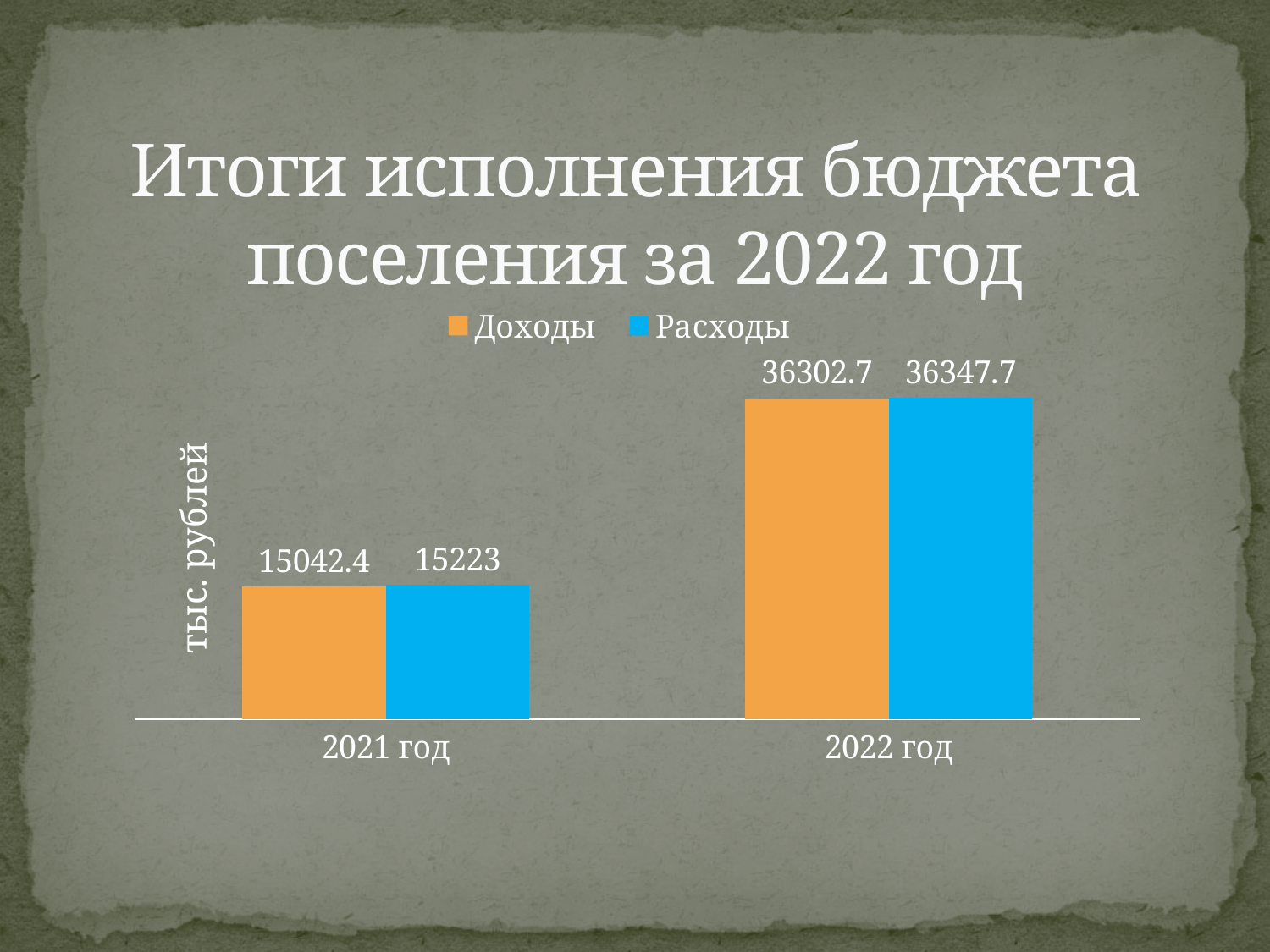
What is the value of Доходы for 2022 год? 36302.7 What is the value of Расходы for 2022 год? 36347.7 Which year has the lower value for Расходы? 2021 год What is the value of Доходы for 2021 год? 15042.4 What is the label of the vertical axis? тыс. рублей What is the difference between Доходы for 2022 год and Доходы for 2021 год? 21260.3 Which year has the higher value for Доходы? 2022 год What is the value of Расходы for 2021 год? 15223 How many series does the legend list? 2 What is the difference between Расходы and Доходы for 2022 год? 45 For 2021 год, which is larger: Доходы or Расходы? Расходы What kind of chart is shown on the slide? Bar chart